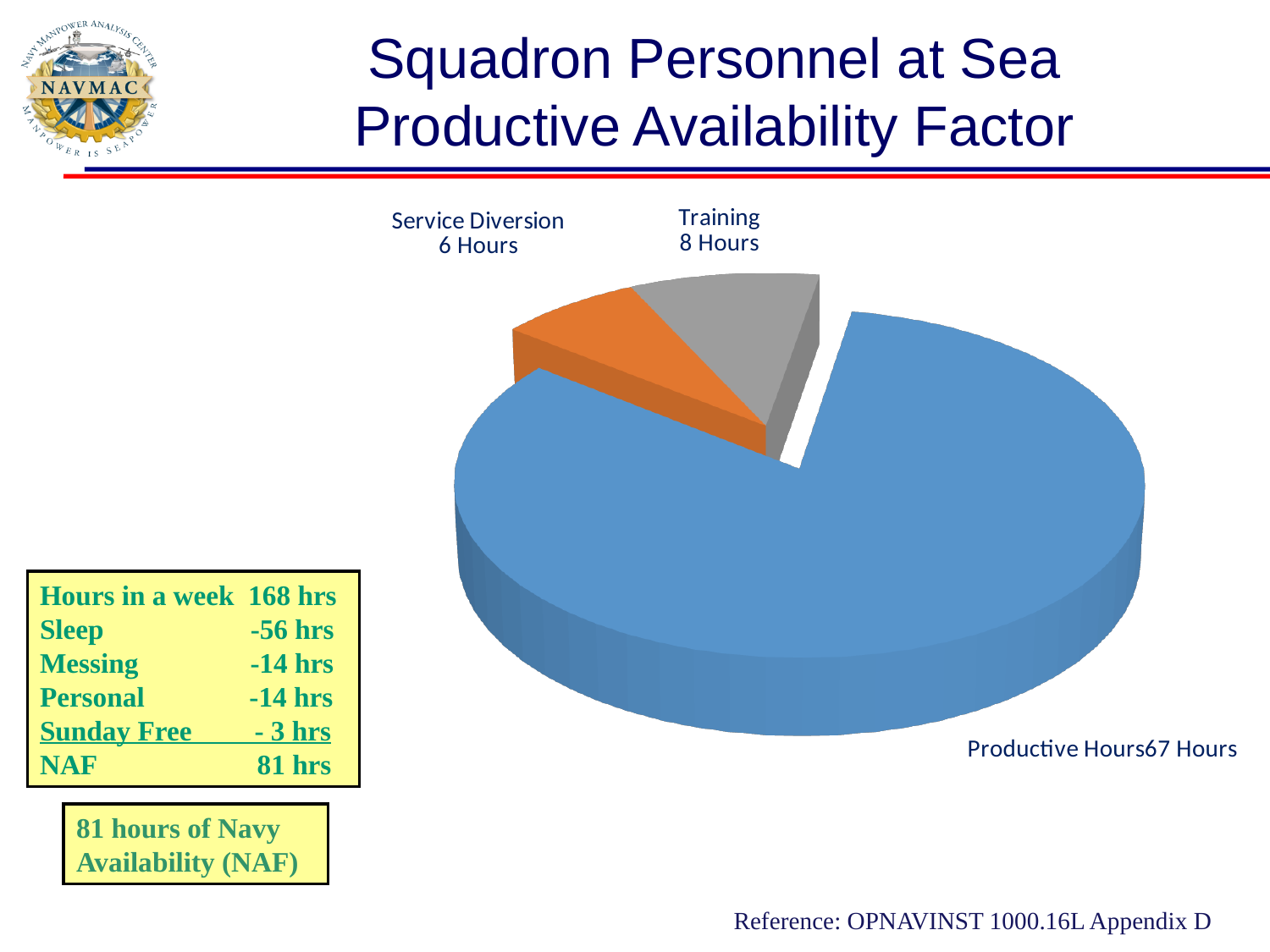
How many hours does the pie chart show for Productive Hours? 67 Hours Which slice of the pie chart is the largest? Productive Hours What is the total number of hours across all slices of the pie chart? 81 hours How many slices does the pie chart have? 3 How many hours does the pie chart show for Training? 8 Hours Which slice of the pie chart is the smallest? Service Diversion How many more hours are shown for Training than for Service Diversion in the pie chart? 2 hours Which is larger in the pie chart, Training or Service Diversion? Training What kind of chart is shown on the slide? Pie chart How many hours does the pie chart show for Service Diversion? 6 Hours How many more hours are shown for Productive Hours than for Training in the pie chart? 59 hours What colour is the Productive Hours slice in the pie chart? Blue